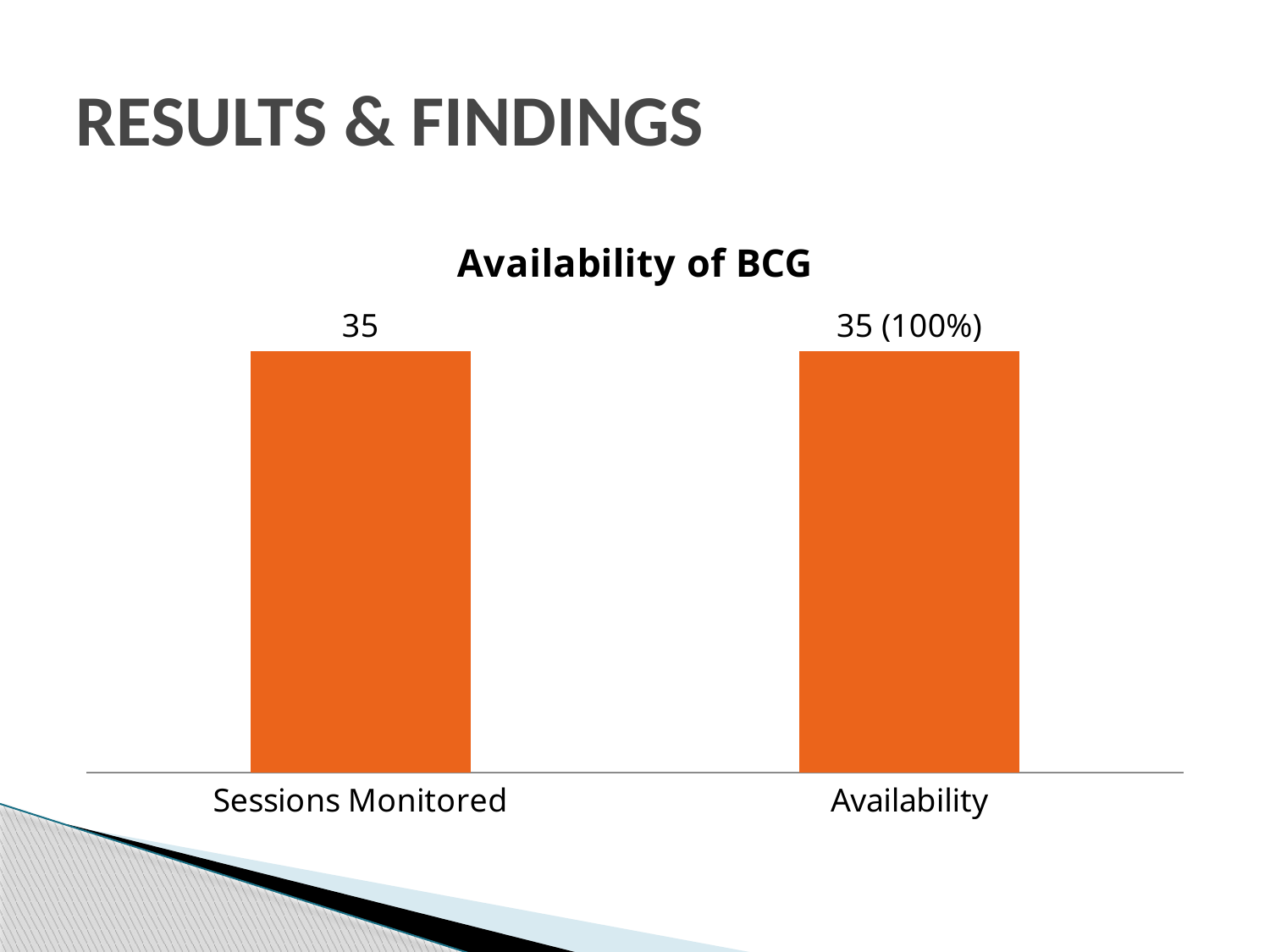
What colour are the bars in the chart? orange What is the title of the chart? Availability of BCG What is the difference between the Sessions Monitored value and the Availability value? 0 What percentage is shown in the data label for Availability? 100% What is the value shown for Sessions Monitored? 35 What kind of chart is shown on the slide? bar chart What is the label of the first category on the x axis? Sessions Monitored How many categories are shown on the x axis of the chart? 2 What is the data label shown on the Availability bar? 35 (100%)